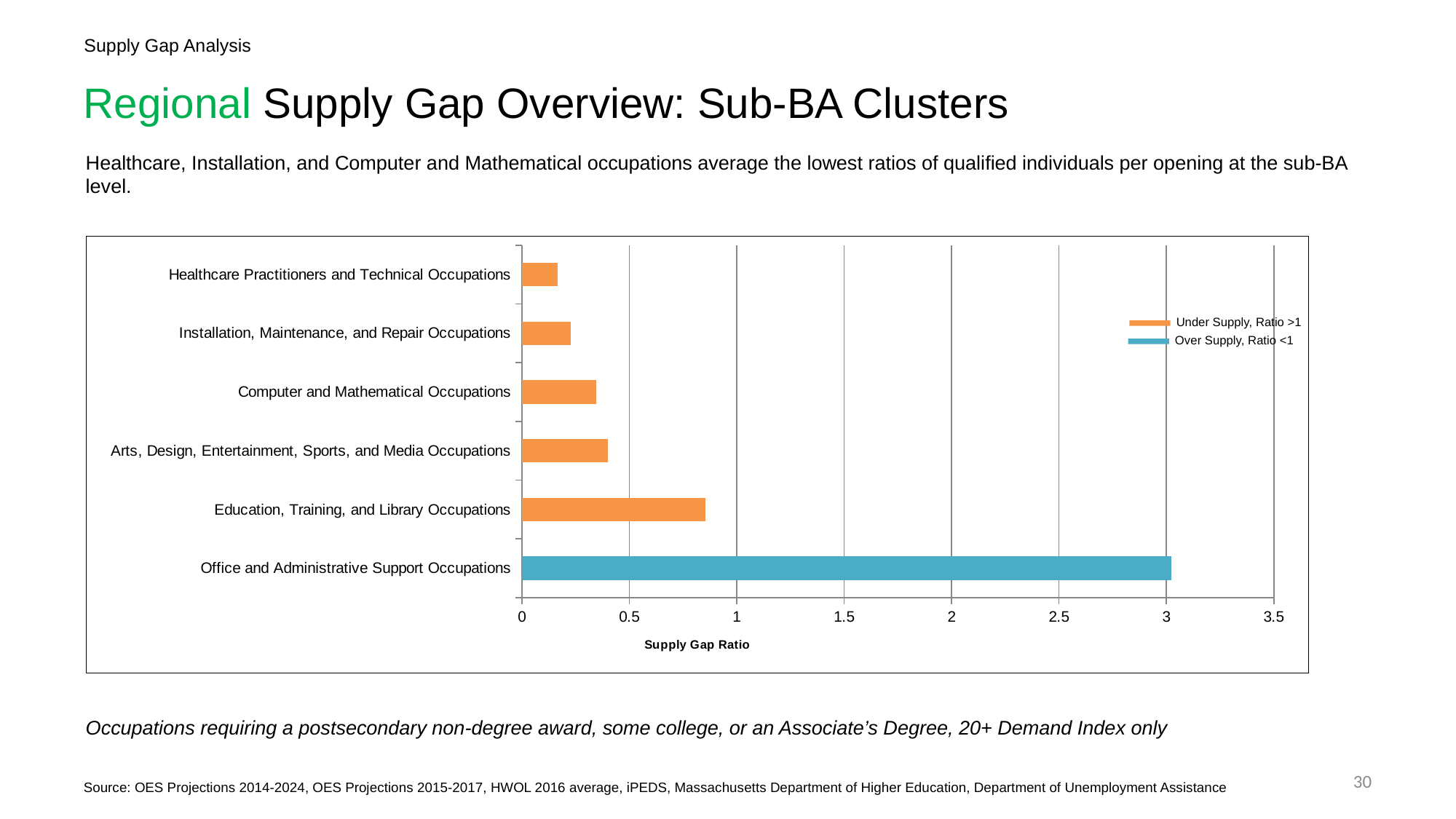
How many occupation categories are plotted in the chart? 6 How many series does the chart legend list? 2 Which legend entry is shown in blue? Over Supply, Ratio <1 Which occupation category has the highest supply gap ratio? Office and Administrative Support Occupations Is the supply gap ratio for Education, Training, and Library Occupations greater or less than 0.5? greater Which has a larger supply gap ratio: Education, Training, and Library Occupations or Arts, Design, Entertainment, Sports, and Media Occupations? Education, Training, and Library Occupations Is the supply gap ratio for Computer and Mathematical Occupations greater or less than 0.5? less Is the supply gap ratio for Education, Training, and Library Occupations greater or less than 1? less What is the label of the horizontal axis of the chart? Supply Gap Ratio Which occupation category has the lowest supply gap ratio? Healthcare Practitioners and Technical Occupations What kind of chart is shown on the slide? bar chart